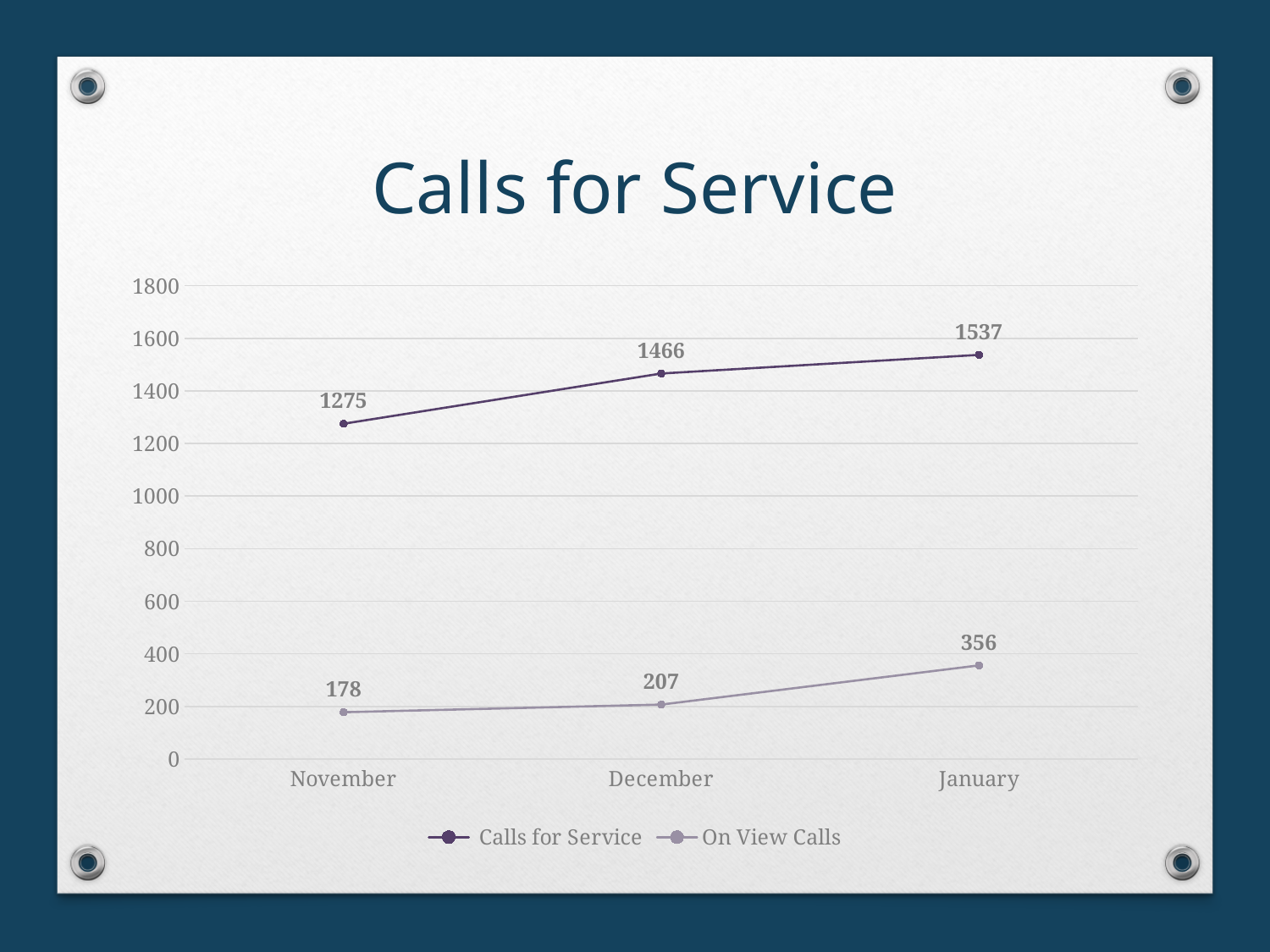
Which is larger: Calls for Service in November or On View Calls in January? Calls for Service in November What is the value for Calls for Service in December? 1466 What is the difference between Calls for Service in January and November? 262 How many series does the legend list? 2 What kind of chart is shown? line chart What is the difference between On View Calls in January and December? 149 What is the value for On View Calls in November? 178 In which month is Calls for Service highest? January Do the Calls for Service values rise or fall from November to January? rise How many months are shown on the x axis? 3 In which month is On View Calls lowest? November What is the value for On View Calls in January? 356